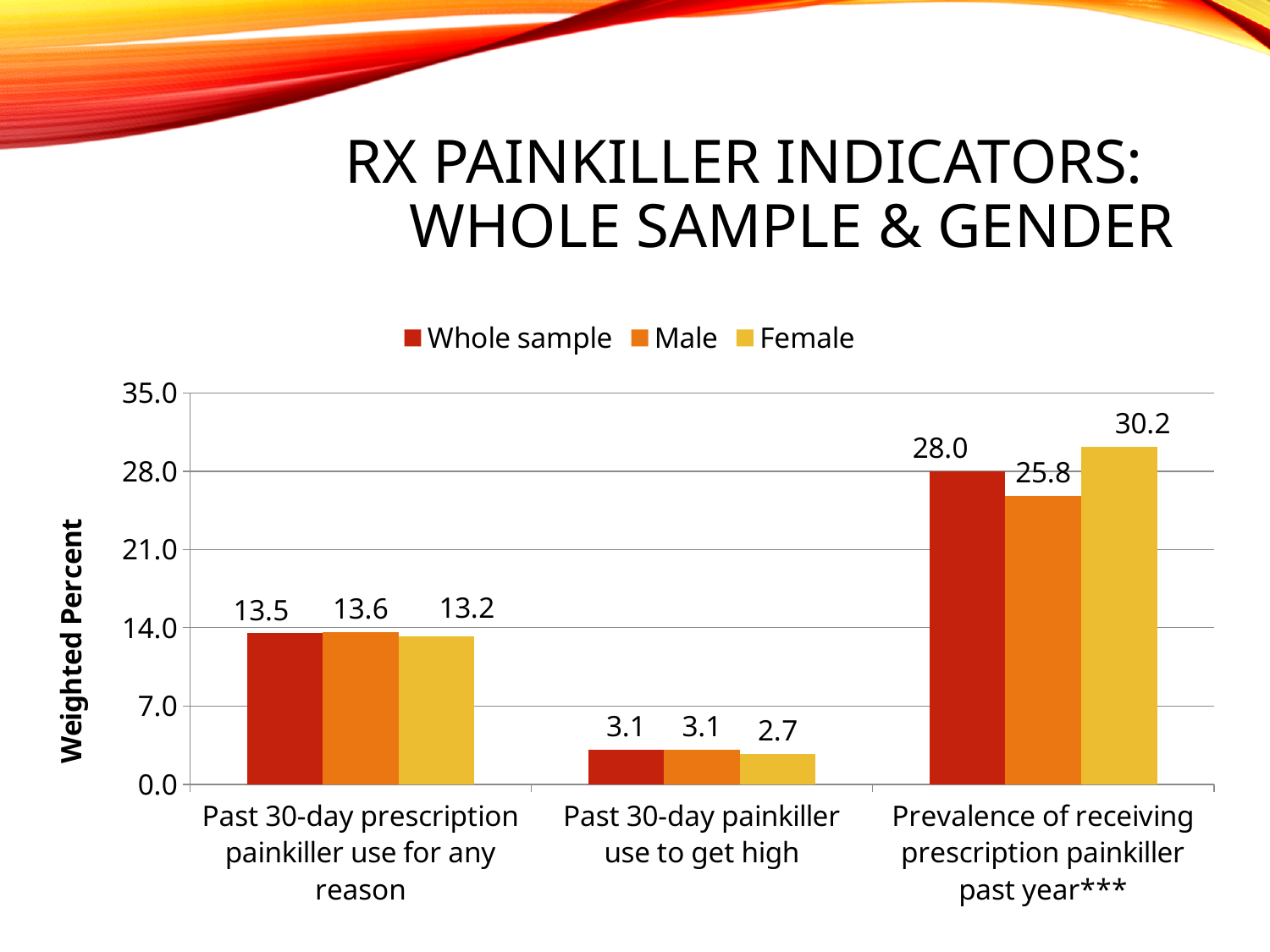
What is the difference between the Female and Male values for Prevalence of receiving prescription painkiller past year***? 4.4 What is the label of the vertical axis? Weighted Percent How many categories are shown on the x axis? 3 What is the Female value for Prevalence of receiving prescription painkiller past year***? 30.2 What is the Male value for Past 30-day painkiller use to get high? 3.1 Is the Whole sample value for Prevalence of receiving prescription painkiller past year*** greater or less than 21.0? greater What kind of chart is shown on the slide? bar chart What is the Whole sample value for Past 30-day prescription painkiller use for any reason? 13.5 How many series does the legend list? 3 Which category has the lowest Female value? Past 30-day painkiller use to get high Which category has the highest Whole sample value? Prevalence of receiving prescription painkiller past year*** For Prevalence of receiving prescription painkiller past year***, which is larger, the Male value or the Female value? Female